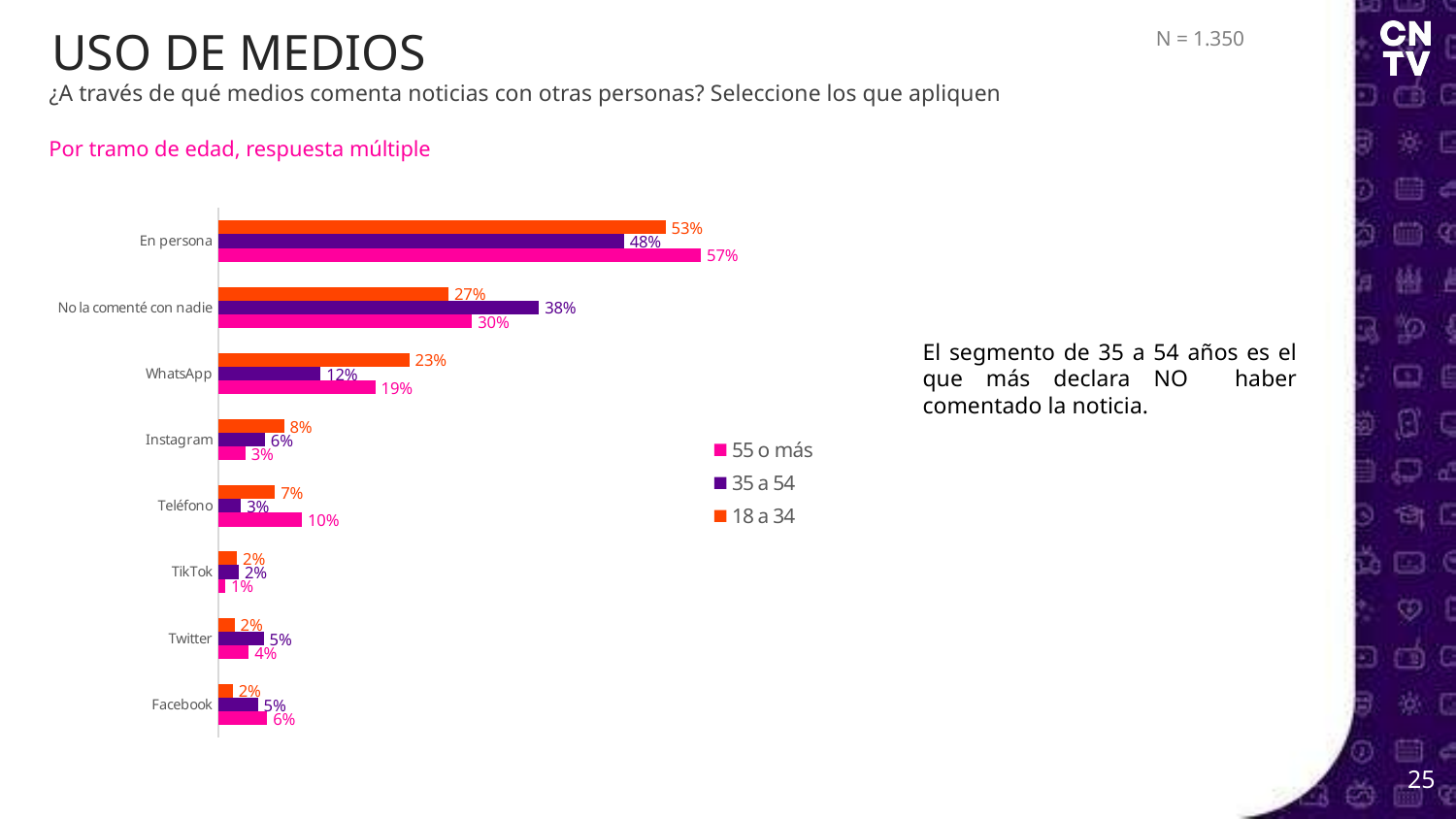
Which category has the highest value in the '18 a 34' series? En persona What is the difference between the '55 o más' and '35 a 54' values for 'En persona'? 9% What is the value for 'No la comenté con nadie' in the '35 a 54' series? 38% What is the value for 'En persona' in the '55 o más' series? 57% Which series is shown in orange in the legend? 18 a 34 What kind of chart is shown on the slide? Bar chart How many series does the legend list? 3 What is the value for 'WhatsApp' in the '18 a 34' series? 23% What is the value for 'Teléfono' in the '55 o más' series? 10% For 'No la comenté con nadie', which series has the larger value: '35 a 54' or '18 a 34'? 35 a 54 Which category has the lowest value in the '55 o más' series? TikTok How many categories are shown on the chart? 8